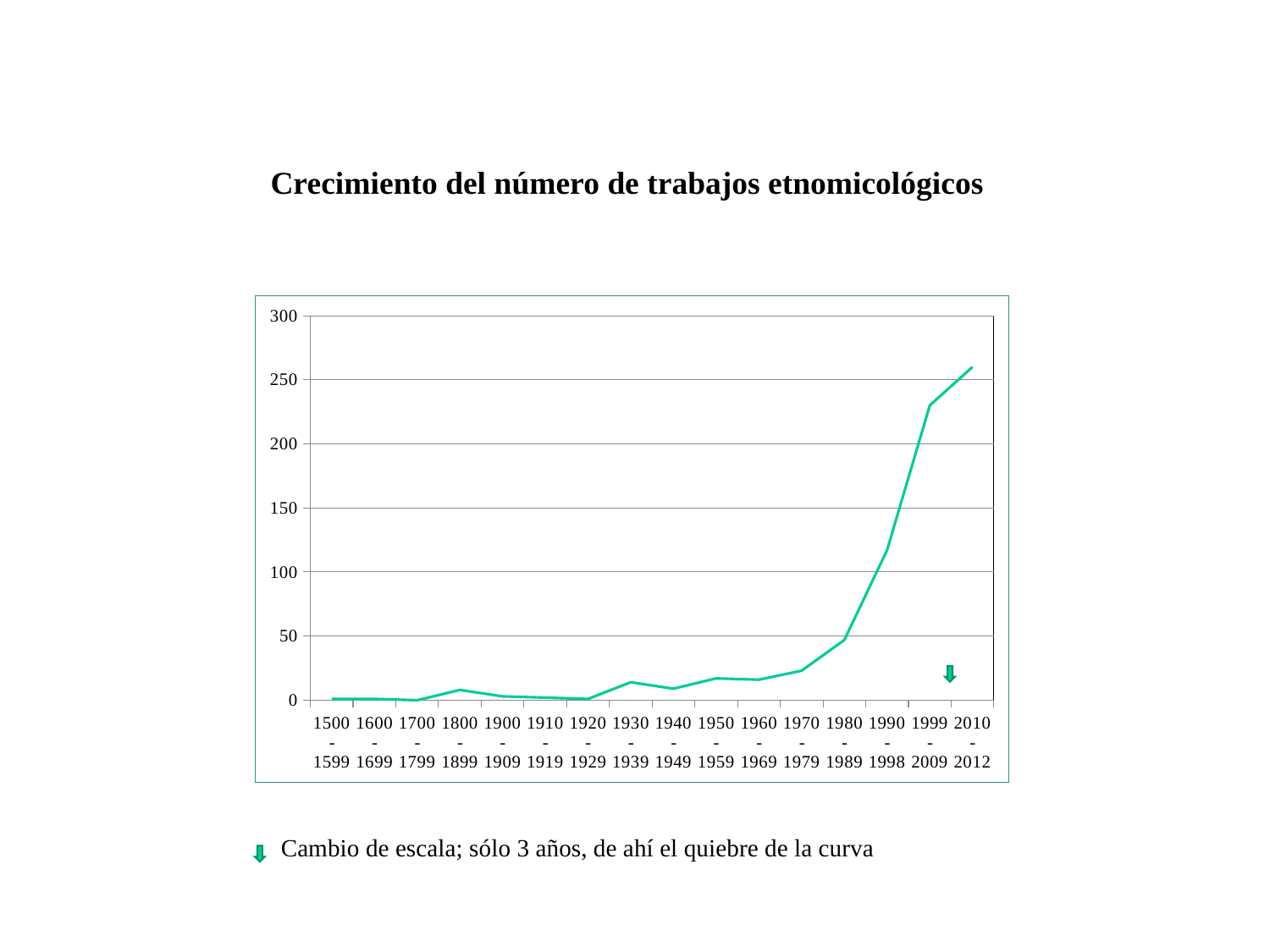
Is the value for 1970-1979 greater or less than 50? less Is the value for 1980-1989 greater or less than 100? less Which period has the highest value? 2010-2012 Is the value for 1990-1998 greater or less than 100? greater What is the title of the chart? Crecimiento del número de trabajos etnomicológicos What kind of chart is shown on the slide? line chart Which is larger, the value for 1980-1989 or the value for 1990-1998? 1990-1998 Do the values generally rise or fall from 1970-1979 to 2010-2012? rise Which is larger, the value for 1999-2009 or the value for 2010-2012? 2010-2012 How many periods are plotted along the x axis? 16